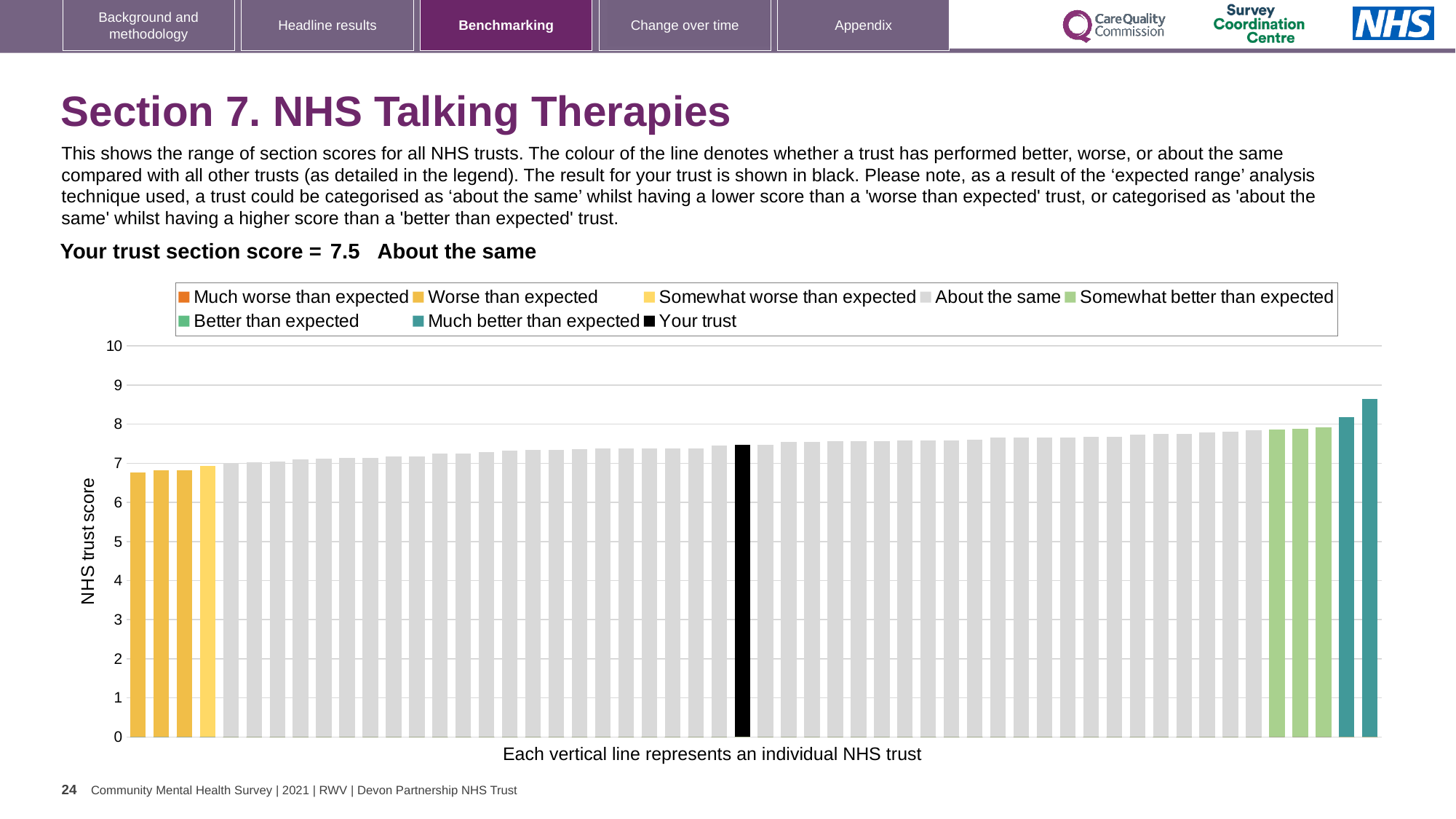
What kind of chart is shown on the slide? Bar chart Do the bar values rise or fall from left to right along the x axis? rise What is the section score for your trust shown on the slide? 7.5 What is the label on the y axis of the chart? NHS trust score How many entries does the chart legend list? 8 Is the value of the tallest bar in the chart greater or less than 8? greater Which category is your trust placed in for this section? About the same What colour is used for the 'Your trust' bar in the chart? Black How many bars are coloured as 'Much better than expected' (teal)? 2 Is the value of the shortest bar in the chart greater or less than 7? less How many bars are coloured as 'Somewhat better than expected' (light green)? 3 Is the value for your trust (the black bar) greater or less than 7? greater